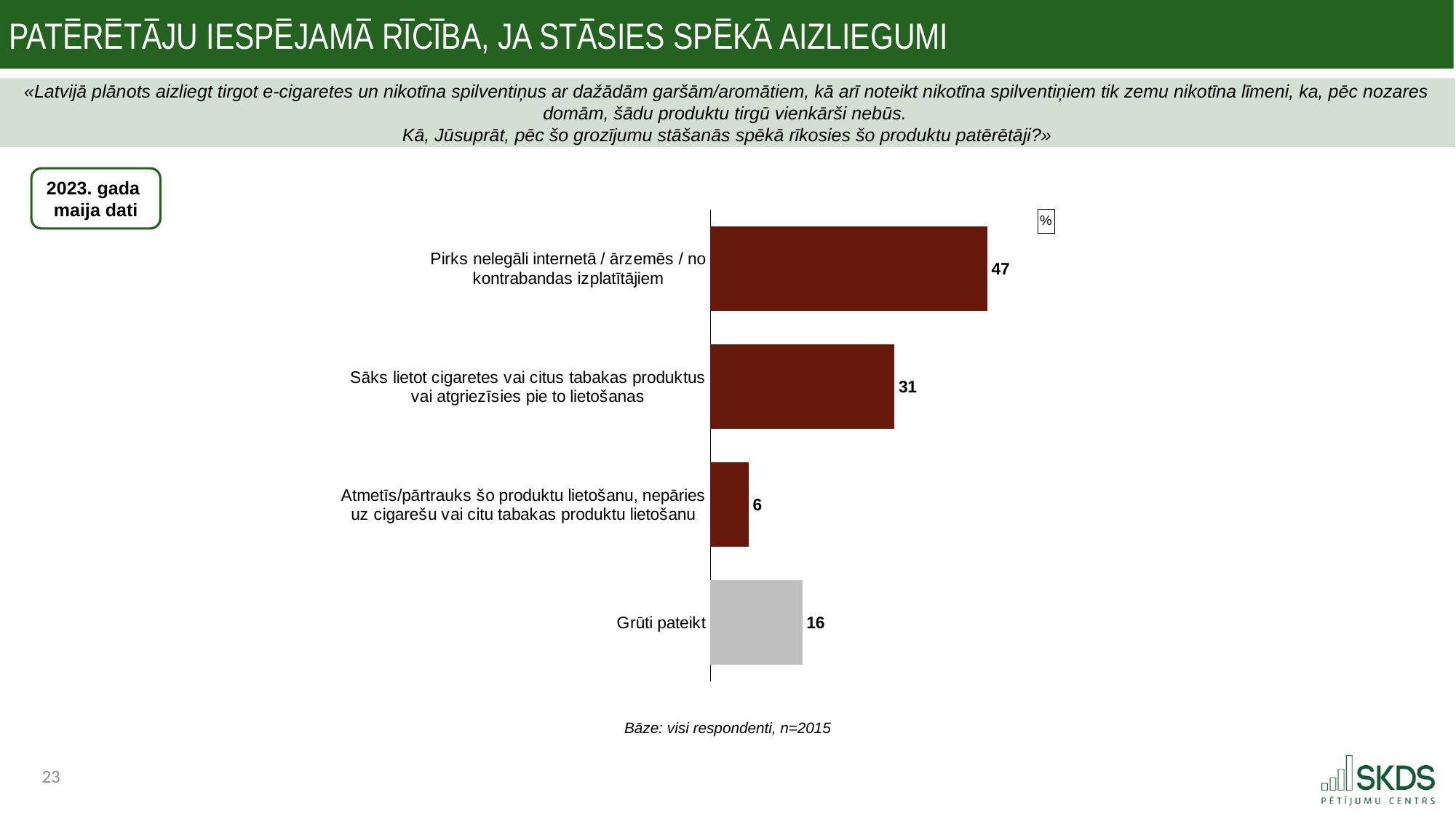
What is the value for "Grūti pateikt"? 16 How many categories are shown in the chart? 4 What is the value for "Sāks lietot cigaretes vai citus tabakas produktus vai atgriezīsies pie to lietošanas"? 31 Which category has the highest value? Pirks nelegāli internetā / ārzemēs / no kontrabandas izplatītājiem Which is larger: the value for "Grūti pateikt" or the value for "Atmetīs/pārtrauks šo produktu lietošanu, nepāries uz cigarešu vai citu tabakas produktu lietošanu"? Grūti pateikt What kind of chart is shown on the slide? Bar chart What is the difference between the values for "Pirks nelegāli internetā / ārzemēs / no kontrabandas izplatītājiem" and "Sāks lietot cigaretes vai citus tabakas produktus vai atgriezīsies pie to lietošanas"? 16 What is the difference between the values for "Grūti pateikt" and "Atmetīs/pārtrauks šo produktu lietošanu, nepāries uz cigarešu vai citu tabakas produktu lietošanu"? 10 What is the value for "Atmetīs/pārtrauks šo produktu lietošanu, nepāries uz cigarešu vai citu tabakas produktu lietošanu"? 6 Which category's bar is coloured grey rather than dark red? Grūti pateikt What is the value for "Pirks nelegāli internetā / ārzemēs / no kontrabandas izplatītājiem"? 47 Which category has the lowest value? Atmetīs/pārtrauks šo produktu lietošanu, nepāries uz cigarešu vai citu tabakas produktu lietošanu